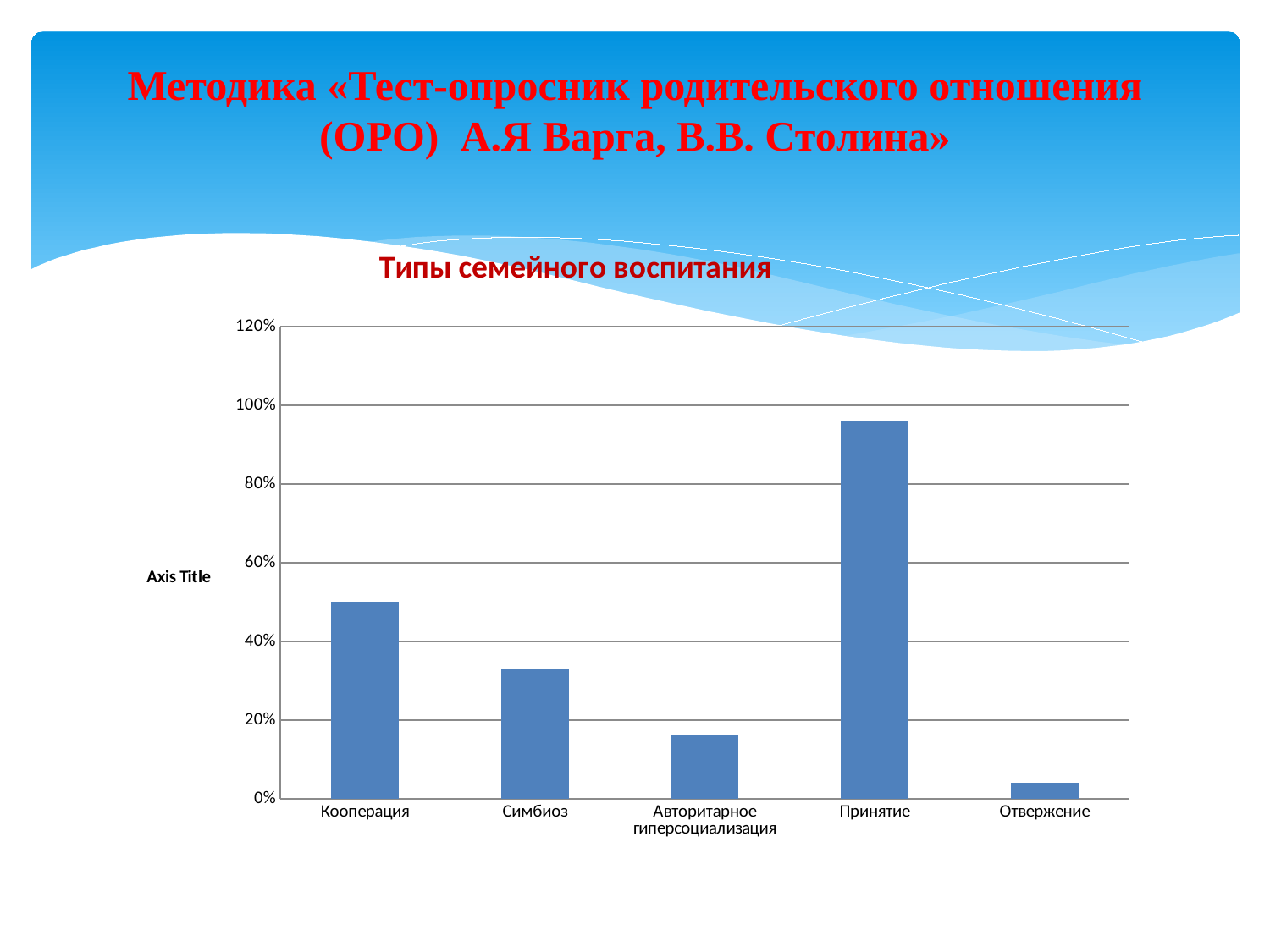
Which category has the highest value in the chart? Принятие What label is shown on the vertical axis of the chart? Axis Title How many categories are shown on the x axis of the chart? 5 Which category has the lowest value in the chart? Отвержение Is the value for Авторитарное гиперсоциализация greater or less than 20%? less Is the value for Симбиоз greater or less than 40%? less Is the value for Кооперация greater or less than 40%? greater What is the title of the chart? Типы семейного воспитания What type of chart is shown on the slide? bar chart Which is larger, the value for Кооперация or the value for Симбиоз? Кооперация Which is larger, the value for Авторитарное гиперсоциализация or the value for Отвержение? Авторитарное гиперсоциализация